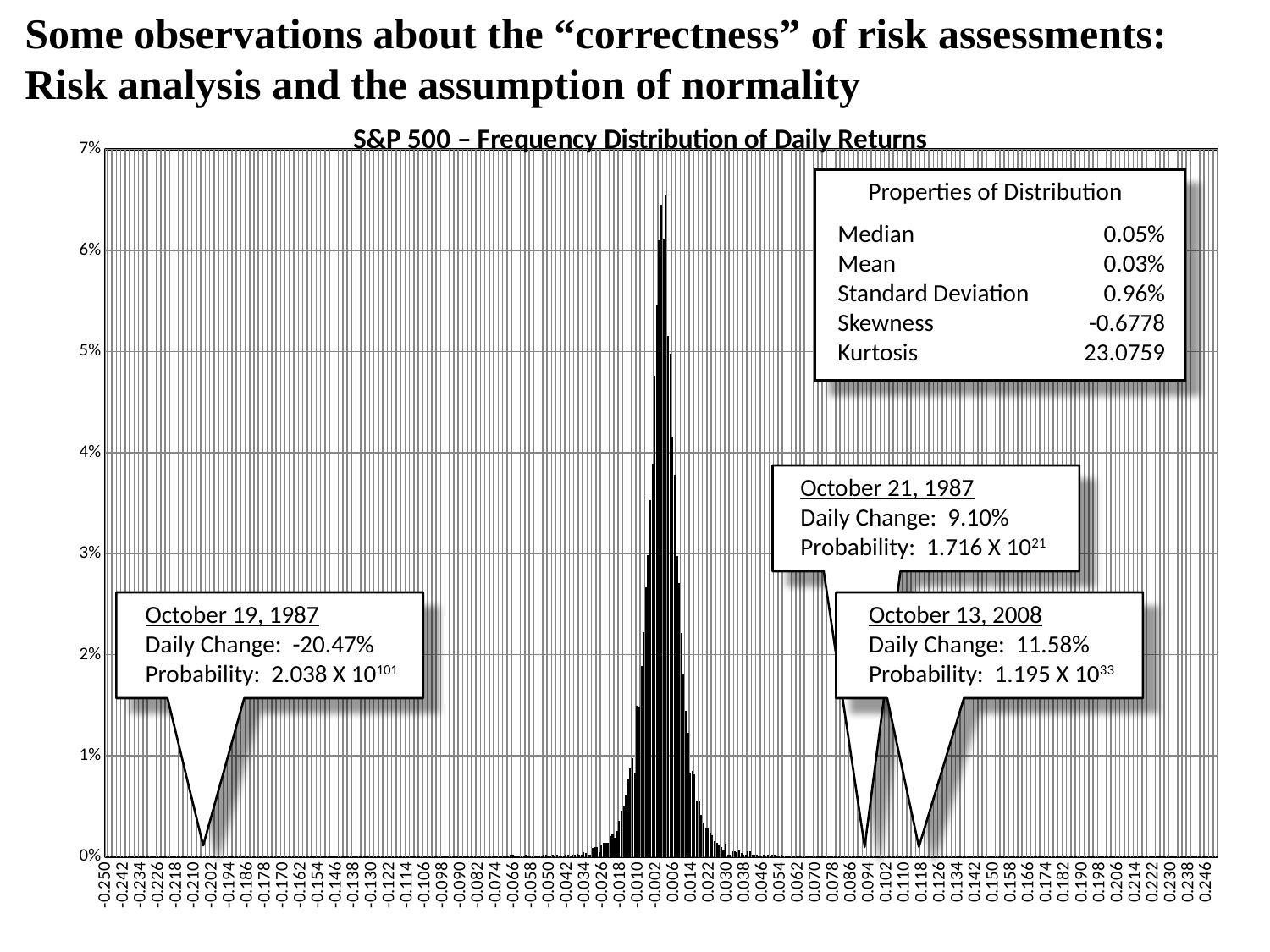
What kind of chart is shown on the slide? bar chart Which is larger, the median or the mean listed in the Properties of Distribution box? Median What kurtosis value is listed in the Properties of Distribution box? 23.0759 According to the Properties of Distribution box, what is the mean? 0.03% What is the highest value shown on the y axis? 7% What is the title of the chart? S&P 500 – Frequency Distribution of Daily Returns What skewness value is listed in the Properties of Distribution box? -0.6778 What daily change is given in the callout for October 19, 1987? -20.47% What standard deviation is listed in the Properties of Distribution box? 0.96% What daily change is given in the callout for October 13, 2008? 11.58% Is the tallest bar in the distribution greater or less than 6%? greater According to the Properties of Distribution box, what is the median? 0.05%